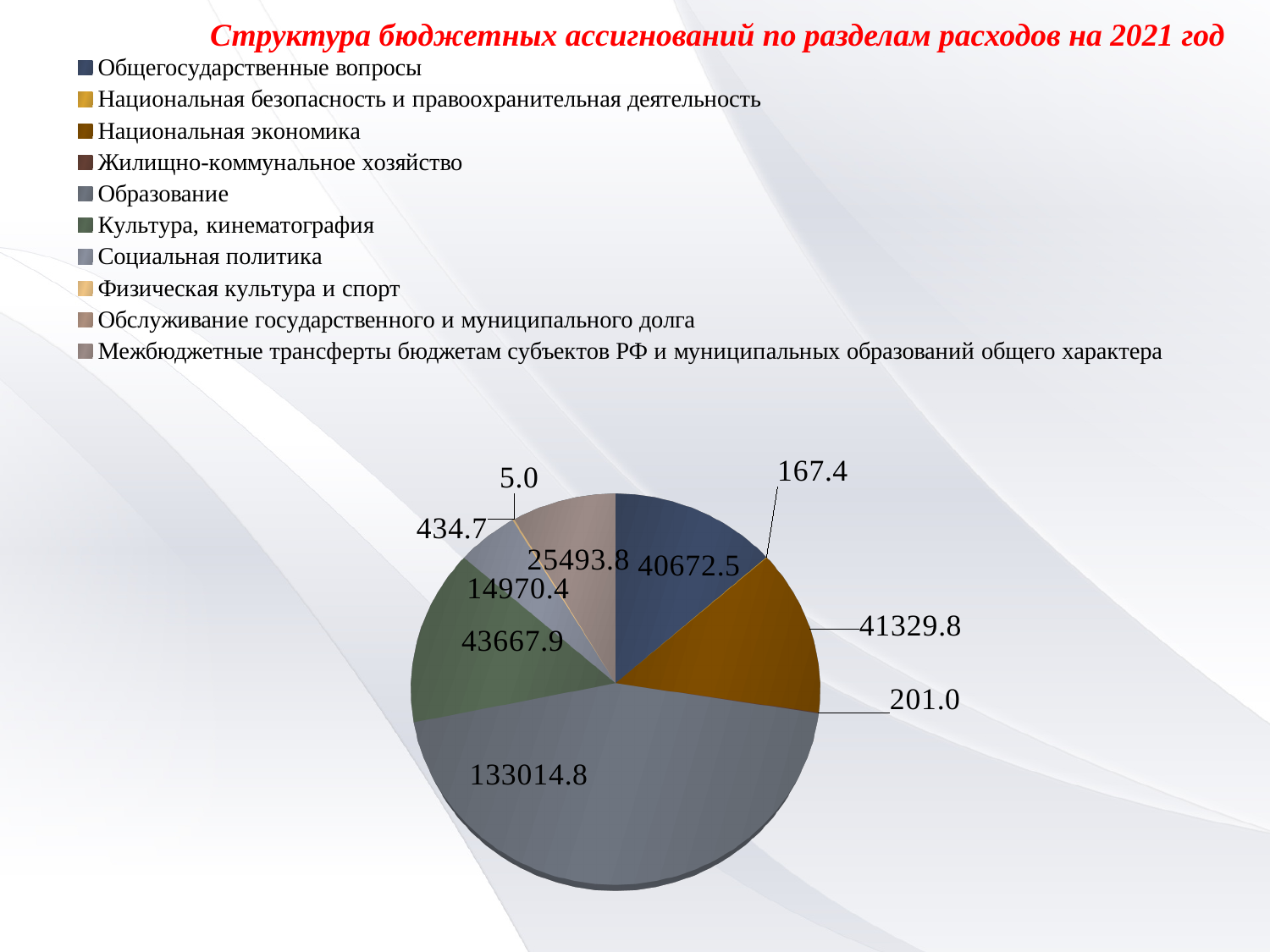
What is the value for Общегосударственные вопросы? 40672.5 What is the difference between the values for Культура, кинематография and Общегосударственные вопросы? 2995.4 What is the value for Культура, кинематография? 43667.9 What is the value for Национальная экономика? 41329.8 What type of chart is shown on the slide? pie chart What is the title of the chart? Структура бюджетных ассигнований по разделам расходов на 2021 год Which is larger, the value for Культура, кинематография or the value for Социальная политика? Культура, кинематография What is the value for Межбюджетные трансферты бюджетам субъектов РФ и муниципальных образований общего характера? 25493.8 How many categories does the legend list? 10 What is the value for Образование? 133014.8 What is the smallest value labelled on the pie? 5.0 Which category has the largest slice of the pie? Образование